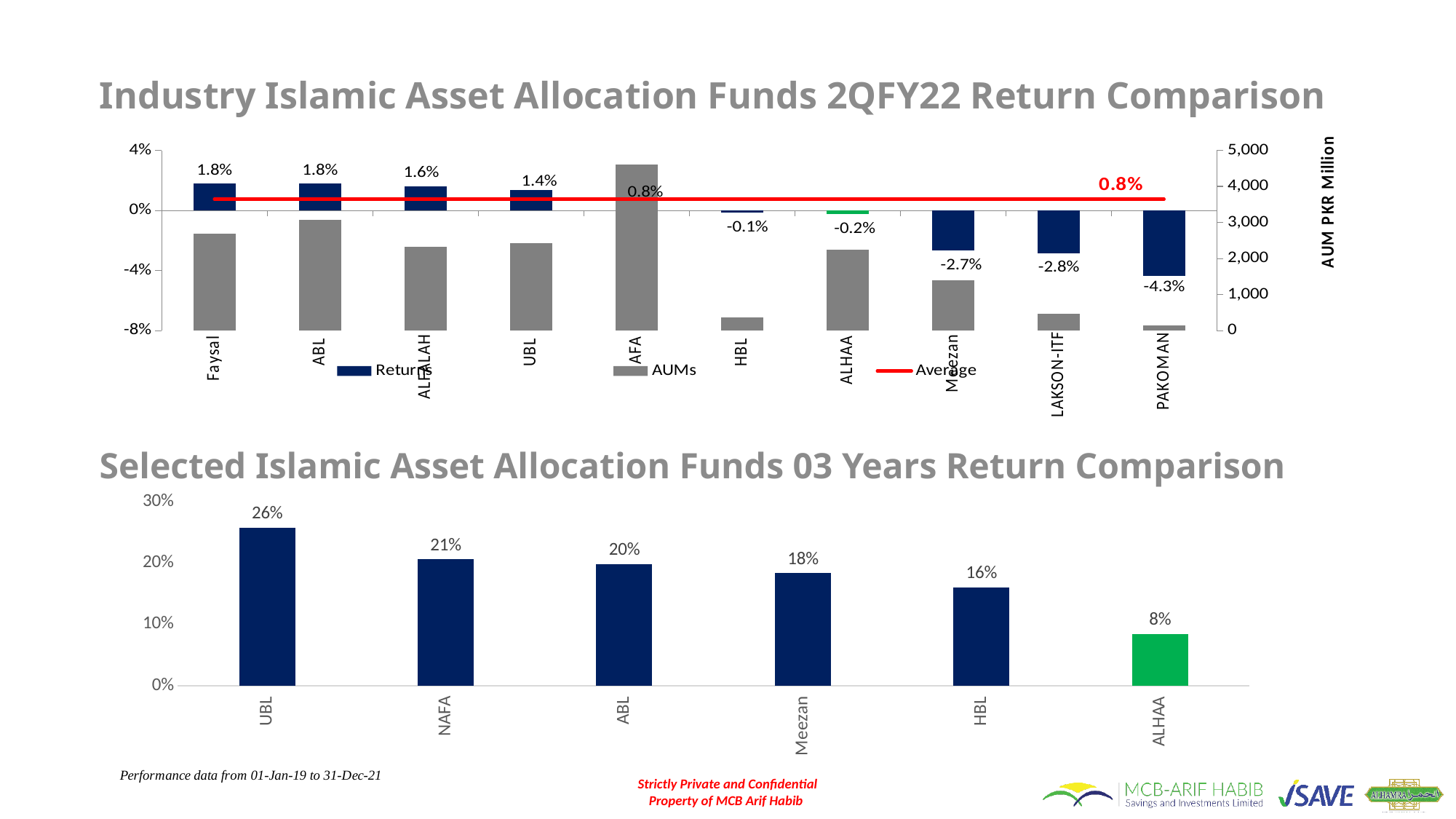
In the 2QFY22 Return Comparison chart, what is the difference between the returns of UBL and Meezan? 4.1% In the 2QFY22 Return Comparison chart, is the AUM for HBL greater or less than 1,000? less In the 03 Years Return Comparison chart, what is the difference between the returns of UBL and ALHAA? 18% How many funds are shown in the 2QFY22 Return Comparison chart? 10 In the 03 Years Return Comparison chart, what is the return for NAFA? 21% In the 2QFY22 Return Comparison chart, what is the value of the Average line? 0.8% In the 2QFY22 Return Comparison chart, is the AUM for AFA greater or less than 4,000? greater In the 2QFY22 Return Comparison chart, what is the return for Faysal? 1.8% In the 2QFY22 Return Comparison chart, which fund has the lowest return? PAKOMAN In the 2QFY22 Return Comparison chart, what is the return for PAKOMAN? -4.3% How many series does the legend of the 2QFY22 Return Comparison chart list? 3 In the 03 Years Return Comparison chart, which fund has the highest return? UBL